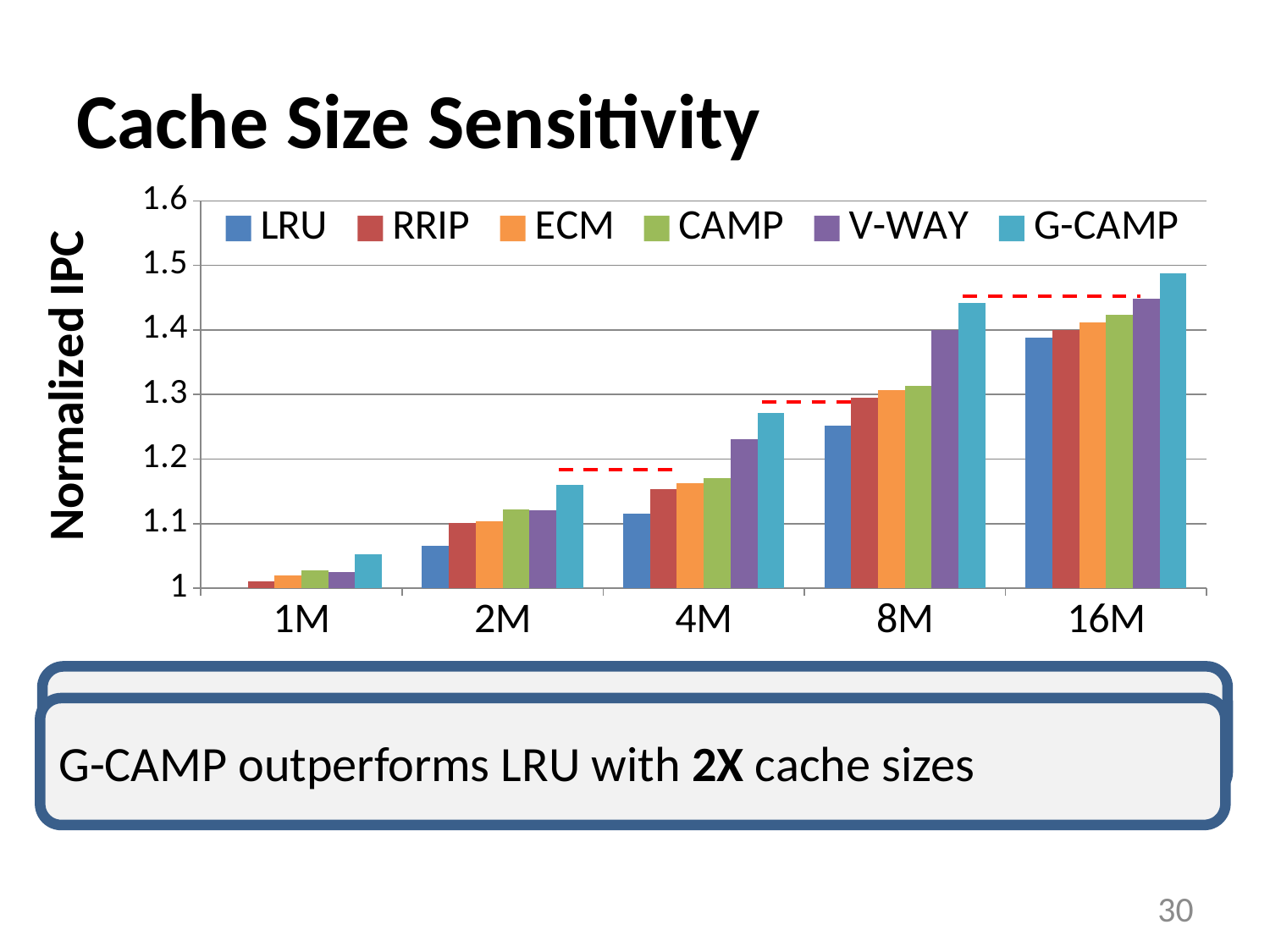
At 8M, which is larger: the value for V-WAY or the value for CAMP? V-WAY Which series has the highest normalized IPC at 8M? G-CAMP Does the normalized IPC for G-CAMP rise or fall as the cache size increases from 1M to 16M? rise What kind of chart is shown on the slide? bar chart Is the value for LRU at 8M greater or less than 1.3? less Is the value for LRU at 2M greater or less than 1.1? less Is the value for G-CAMP at 16M greater or less than 1.4? greater What is the label of the y axis? Normalized IPC How many cache size categories are shown on the x axis? 5 Which series has the lowest normalized IPC at 16M? LRU How many series does the legend list? 6